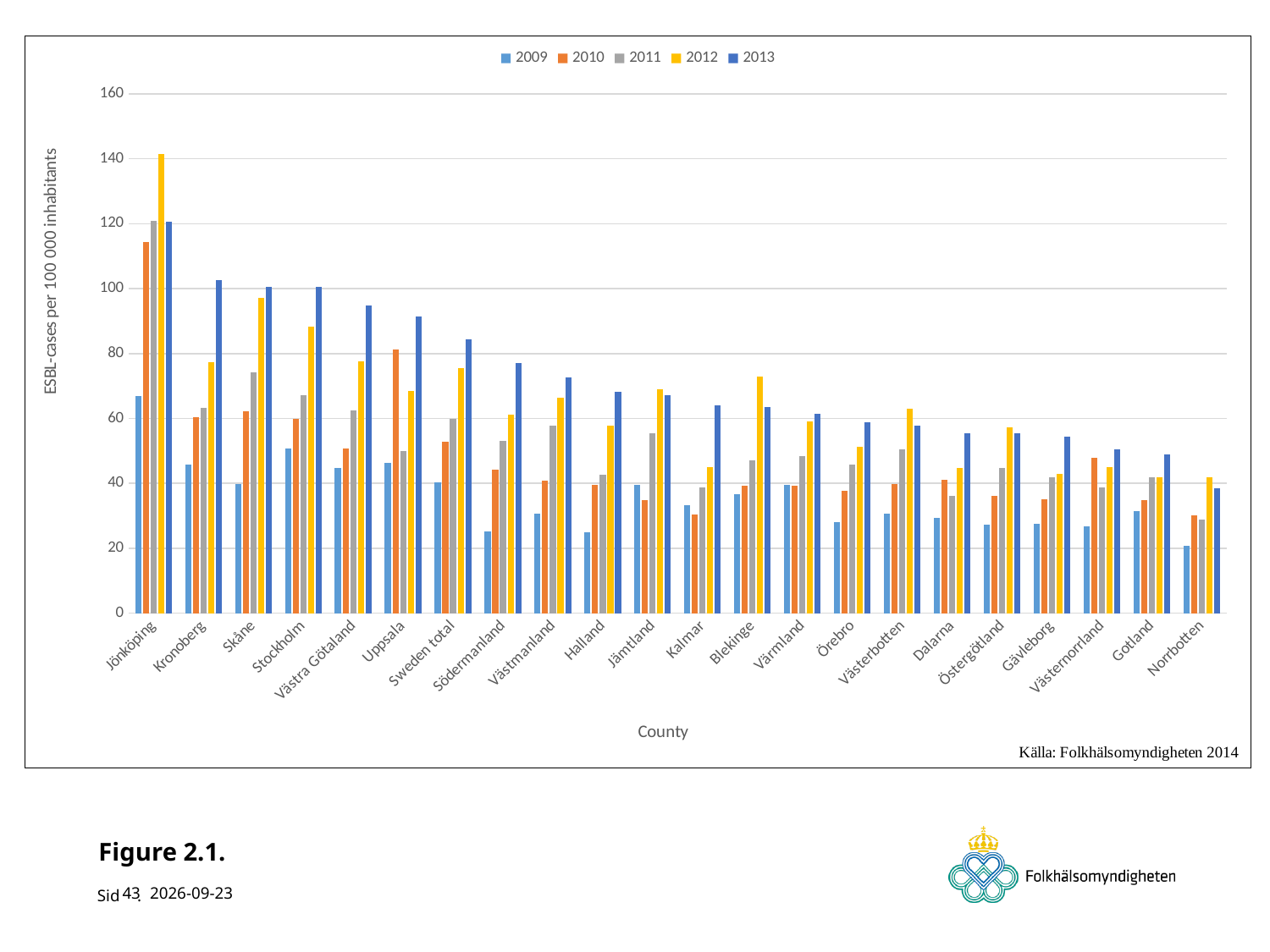
Is the 2012 value for Jönköping greater or less than 120? greater For Jönköping, which is larger: the 2012 value or the 2013 value? 2012 Is the 2010 value for Jönköping greater or less than 100? greater Is the 2012 value for Blekinge greater or less than 60? greater What is the label of the y axis? ESBL-cases per 100 000 inhabitants How many series does the legend list? 5 What kind of chart is shown on the slide? bar chart Which county has the lowest 2009 value? Norrbotten Which county has the highest 2012 value? Jönköping How many counties (categories) are shown on the x axis? 22 For Uppsala, which is larger: the 2010 value or the 2011 value? 2010